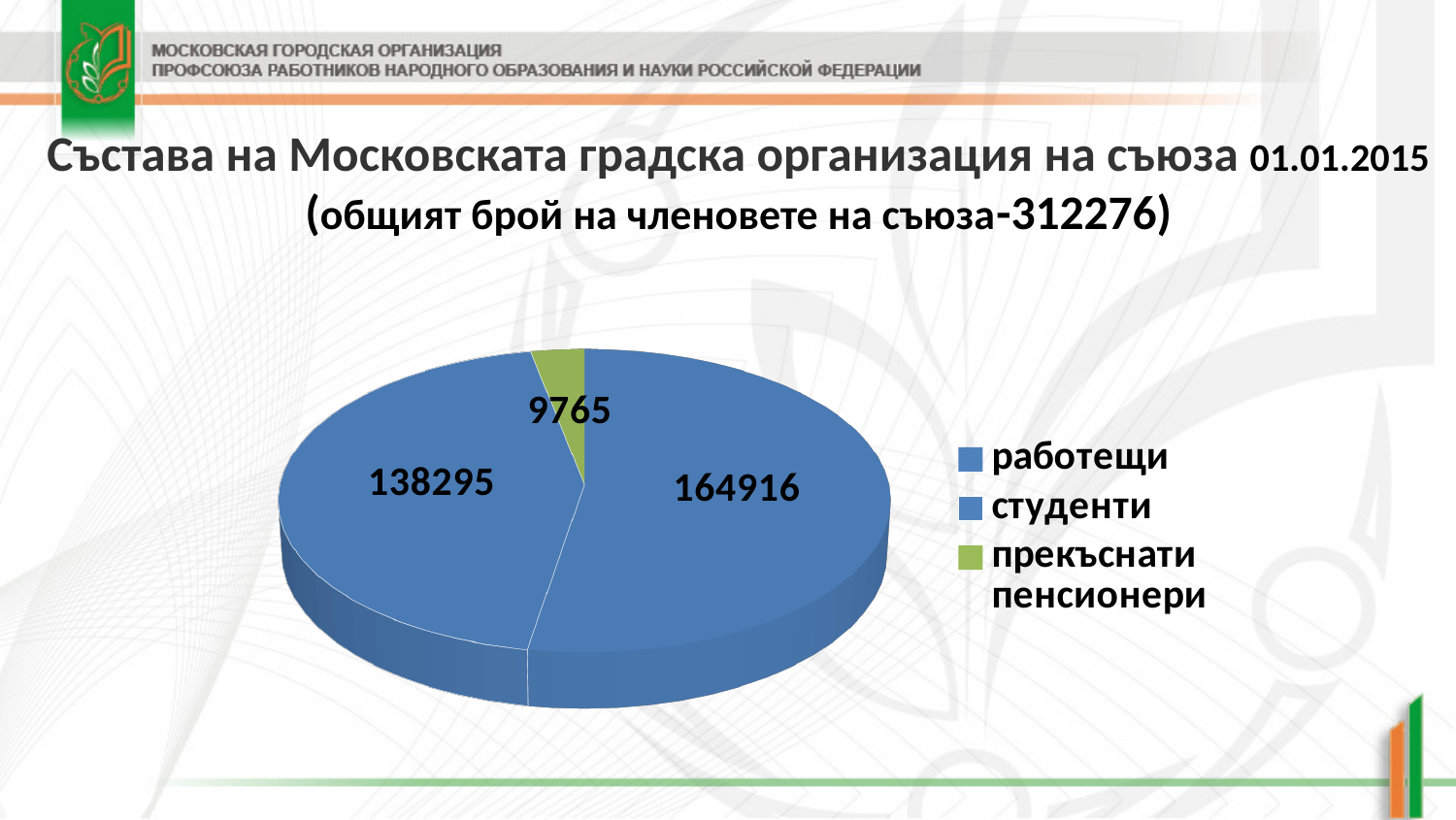
What is the difference between the slice labelled 138295 and the slice labelled 9765? 128530 What is the value of the smallest slice in the pie chart? 9765 Which is larger: the slice labelled 138295 or the slice labelled 9765? 138295 How many slices does the pie chart have? 3 What is the difference between the largest slice (164916) and the smallest slice (9765)? 155151 What total number of union members is stated in the slide title? 312276 What colour is the slice for прекъснати пенсионери in the pie chart? green What is the difference between the two largest slices, 164916 and 138295? 26621 How many entries does the legend of the pie chart list? 3 What kind of chart is shown on the slide? pie chart What is the value of the largest slice in the pie chart? 164916 What is the value shown for прекъснати пенсионери in the pie chart? 9765